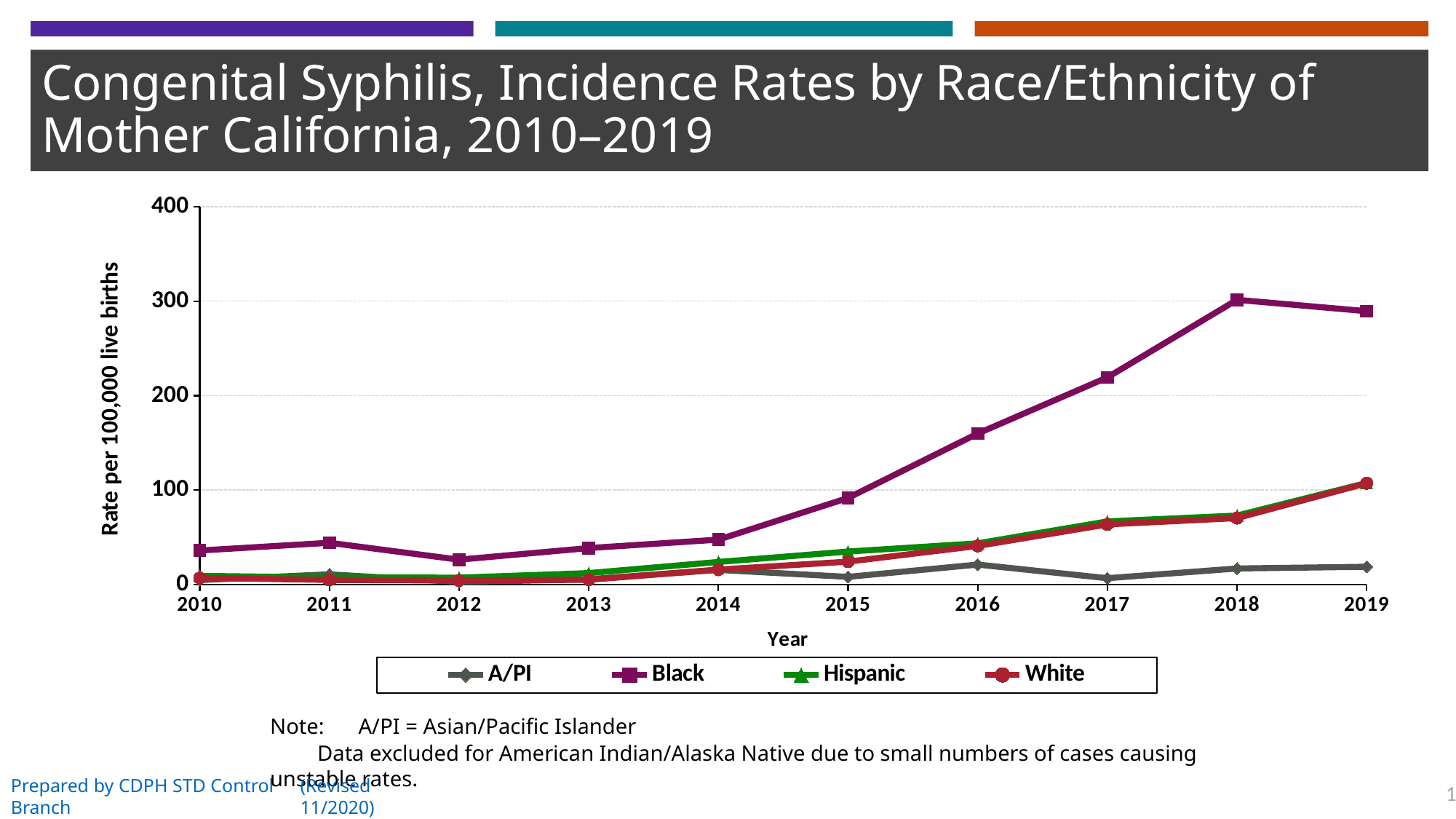
How many series does the legend list? 4 Does the rate for Black mothers generally rise or fall from 2012 to 2018? rise Is the rate for Black mothers in 2017 greater or less than 200? greater Is the rate for A/PI mothers in 2016 greater or less than 100? less What does A/PI stand for according to the note on the slide? Asian/Pacific Islander Which race/ethnicity has the highest rate in 2019? Black How many years are plotted along the x axis? 10 What is the label on the y axis? Rate per 100,000 live births Which is larger in 2018, the rate for Black mothers or the rate for White mothers? Black What kind of chart is shown on the slide? line chart Which race/ethnicity has the lowest rate in 2019? A/PI Is the rate for Black mothers in 2016 greater or less than 200? less